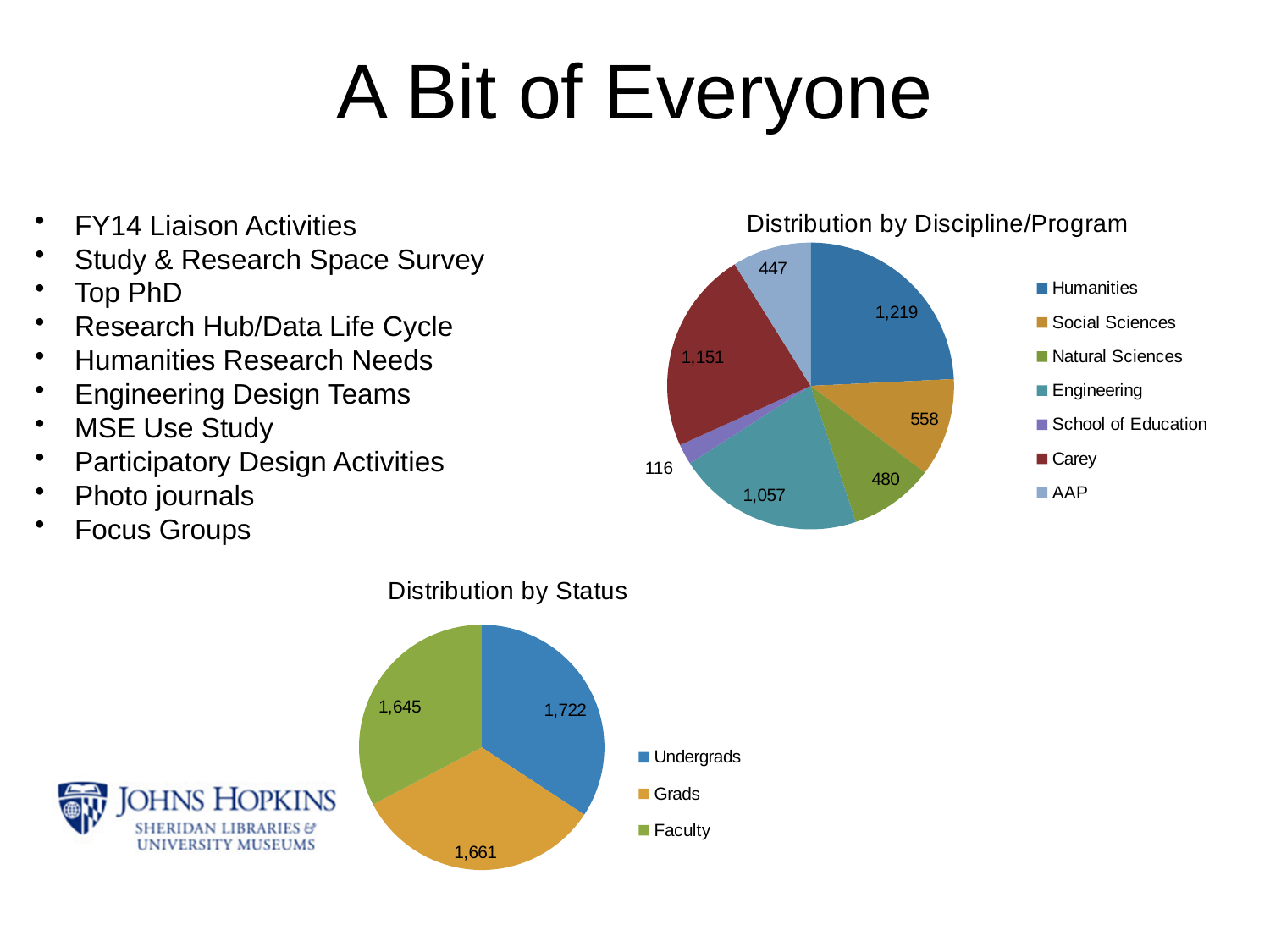
How many categories does the Distribution by Discipline/Program chart show? 7 In the Distribution by Status chart, what is the difference between Undergrads and Faculty? 77 In the Distribution by Discipline/Program chart, what is the value for Engineering? 1,057 In the Distribution by Discipline/Program chart, what is the difference between Social Sciences and Natural Sciences? 78 In the Distribution by Discipline/Program chart, which category has the largest value? Humanities In the Distribution by Status chart, which category has the largest value? Undergrads In the Distribution by Status chart, what is the total of all three categories? 5,028 In the Distribution by Discipline/Program chart, what is the value for Humanities? 1,219 In the Distribution by Discipline/Program chart, which category has the smallest value? School of Education In the Distribution by Status chart, what is the value for Grads? 1,661 What type of chart is the Distribution by Status chart? Pie chart In the Distribution by Discipline/Program chart, which is larger, Carey or AAP? Carey